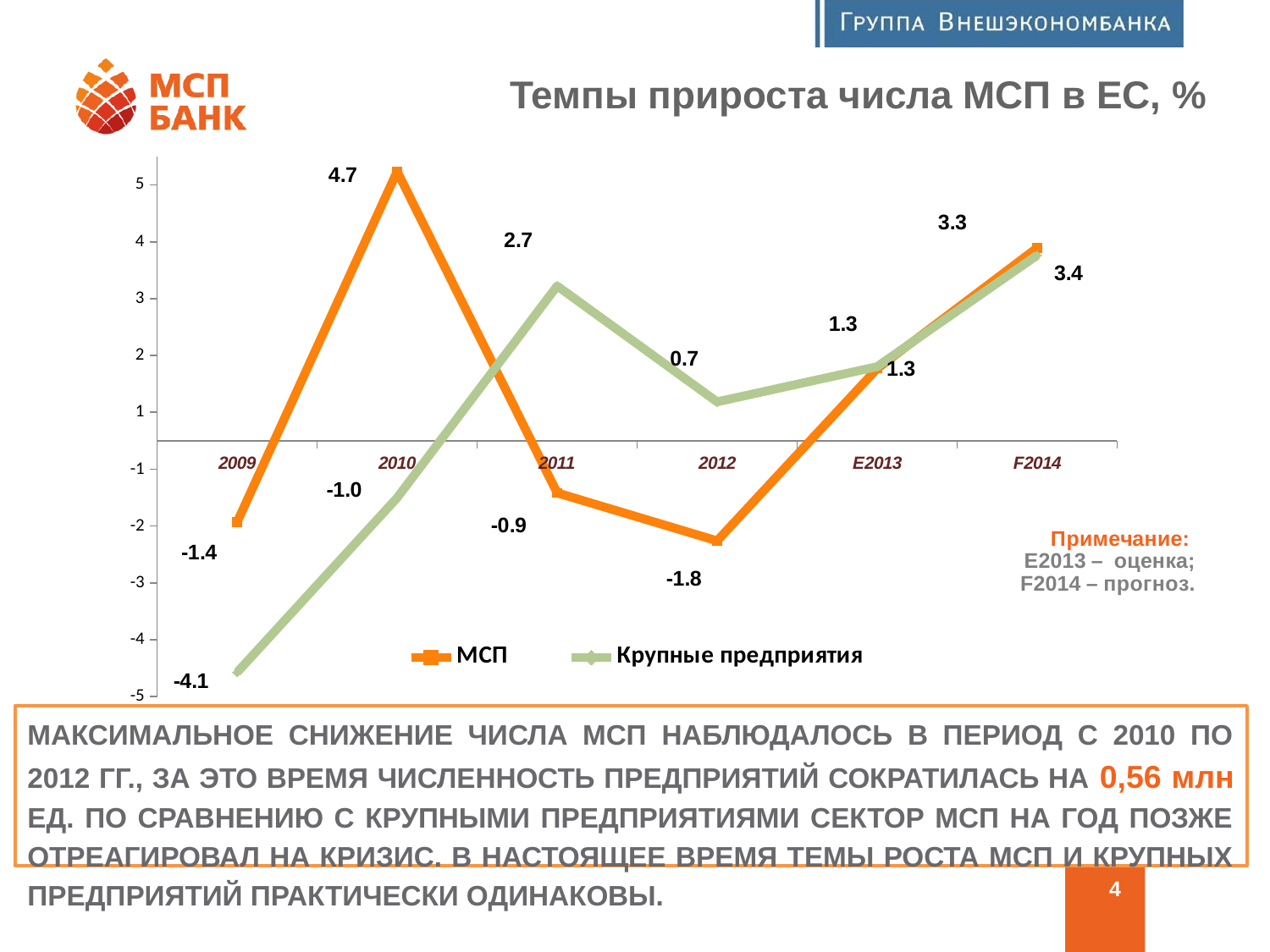
What is the difference between the МСП values for 2010 and 2011? 5.6 What is the value for МСП in 2012? -1.8 What type of chart is shown on the slide? Line chart How many series does the legend list? 2 In which year is the Крупные предприятия series at its lowest? 2009 What is the value for Крупные предприятия in 2011? 2.7 What is the value for Крупные предприятия in 2009? -4.1 In 2012, which series has the larger value, МСП or Крупные предприятия? Крупные предприятия What is the value for МСП in 2010? 4.7 In which year is the МСП series at its highest? 2010 What is the title of the chart? Темпы прироста числа МСП в ЕС, % How many years (categories) are shown on the x axis? 6